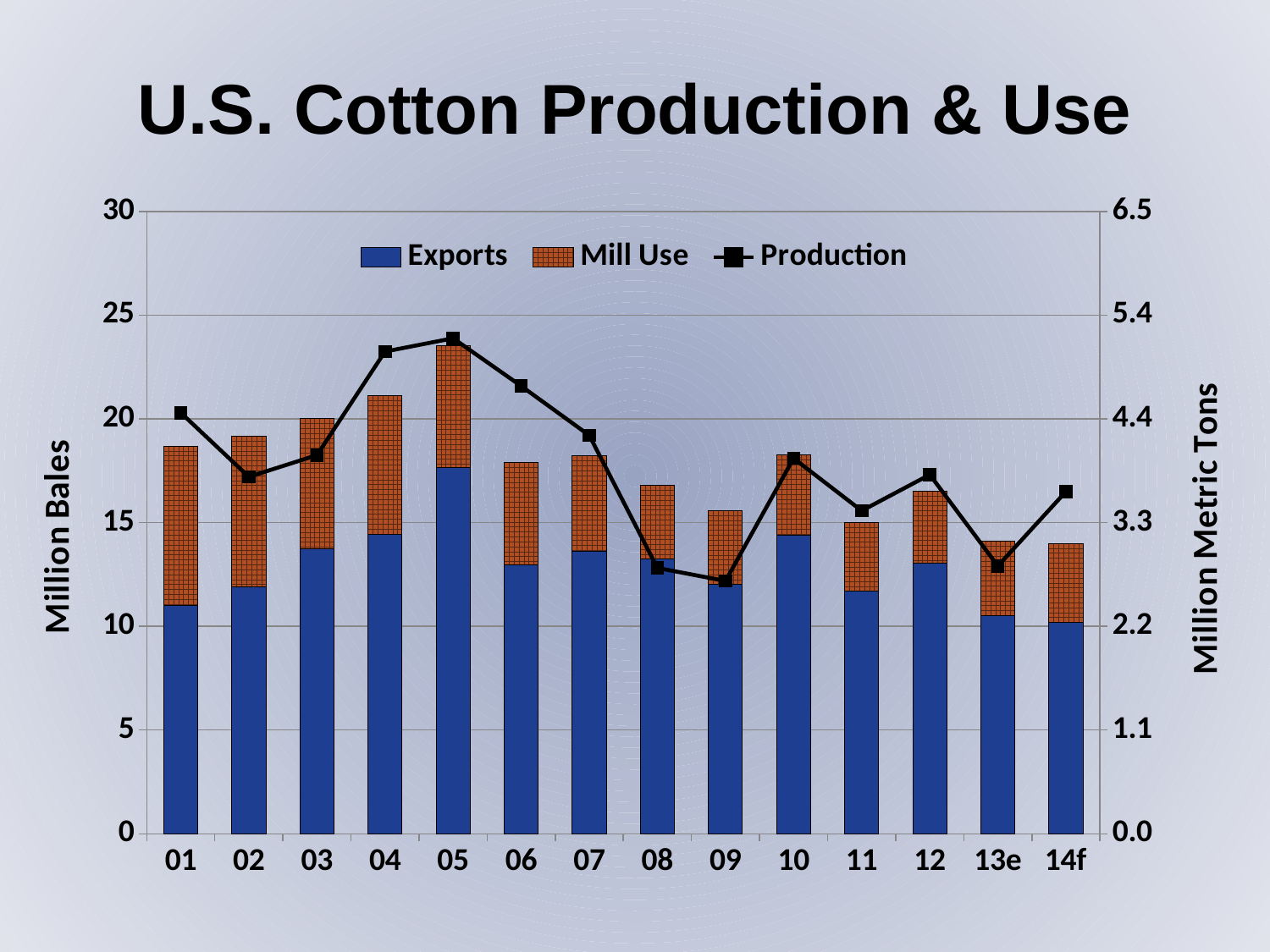
Is the Exports value for 14f greater or less than 15 million bales? less How many years are shown along the x axis? 14 Which year has the highest Exports value? 05 What kind of chart is shown on the slide? A combined bar and line chart (stacked bars with a line) Is the Exports value for 05 greater or less than 15 million bales? greater Is the Production value for 04 greater or less than 4.4 million metric tons? greater Which year has the tallest stacked bar (Exports plus Mill Use)? 05 How many series does the legend list? 3 Which year has the highest Production value? 05 Which is larger, the Exports value for 05 or for 01? 05 Does Production rise or fall from 05 to 09? fall